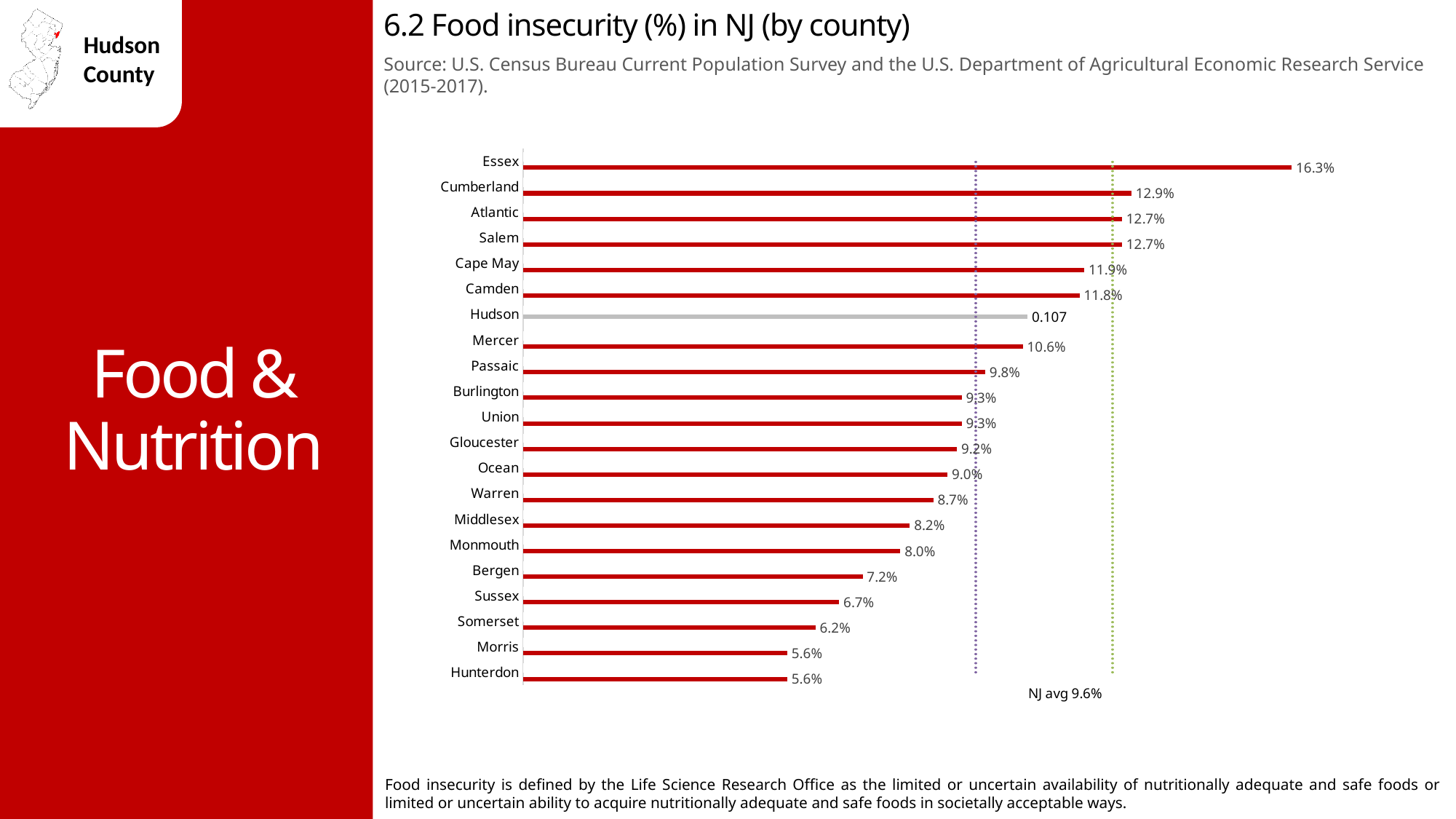
What is the food insecurity value shown for Bergen? 7.2% What is the food insecurity value shown for Essex? 16.3% What is the difference between the values for Cumberland and Camden? 1.1% What value is printed next to the Hudson bar? 0.107 What is the difference between the values for Essex and Hunterdon? 10.7% What NJ average value is labeled on the chart? 9.6% How many counties are plotted on the chart? 21 Which has a higher food insecurity value, Passaic or Warren? Passaic Which county's bar is drawn in grey rather than red? Hudson What is the food insecurity value shown for Mercer? 10.6% What kind of chart is shown on the slide? Bar chart Which county has the highest food insecurity value on the chart? Essex